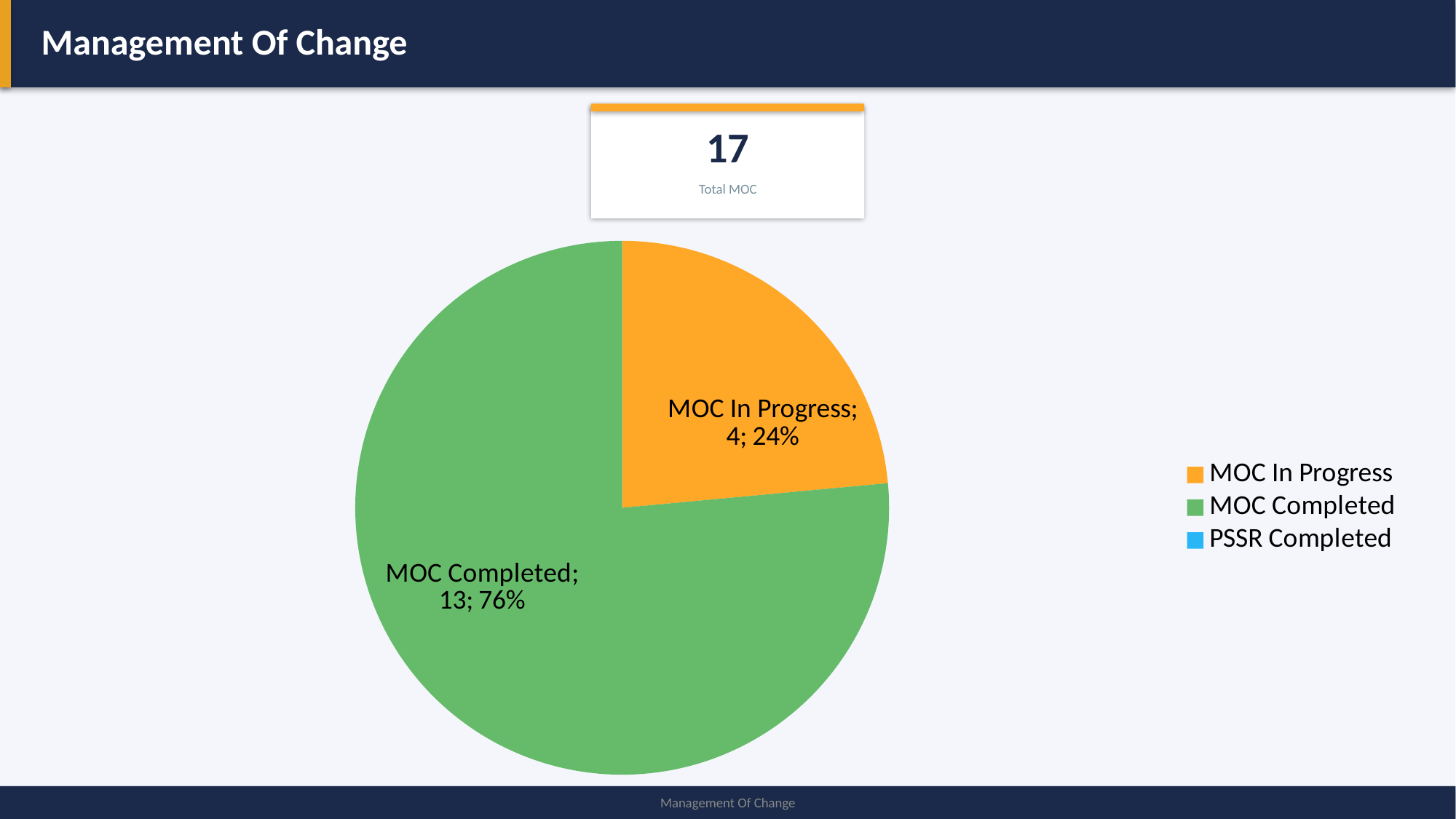
Which slice of the pie chart is the largest? MOC Completed How many entries does the legend list? 3 What share of the pie does MOC Completed represent? 76% What is the Total MOC shown on the slide? 17 Which is larger, MOC Completed or MOC In Progress? MOC Completed How many MOC In Progress are shown in the pie chart? 4 What kind of chart is shown on the slide? pie chart What colour is the MOC Completed slice? green Which of the two visible slices is the smallest? MOC In Progress What is the difference between the MOC Completed count and the MOC In Progress count? 9 What share of the pie does MOC In Progress represent? 24% How many MOC Completed are shown in the pie chart? 13